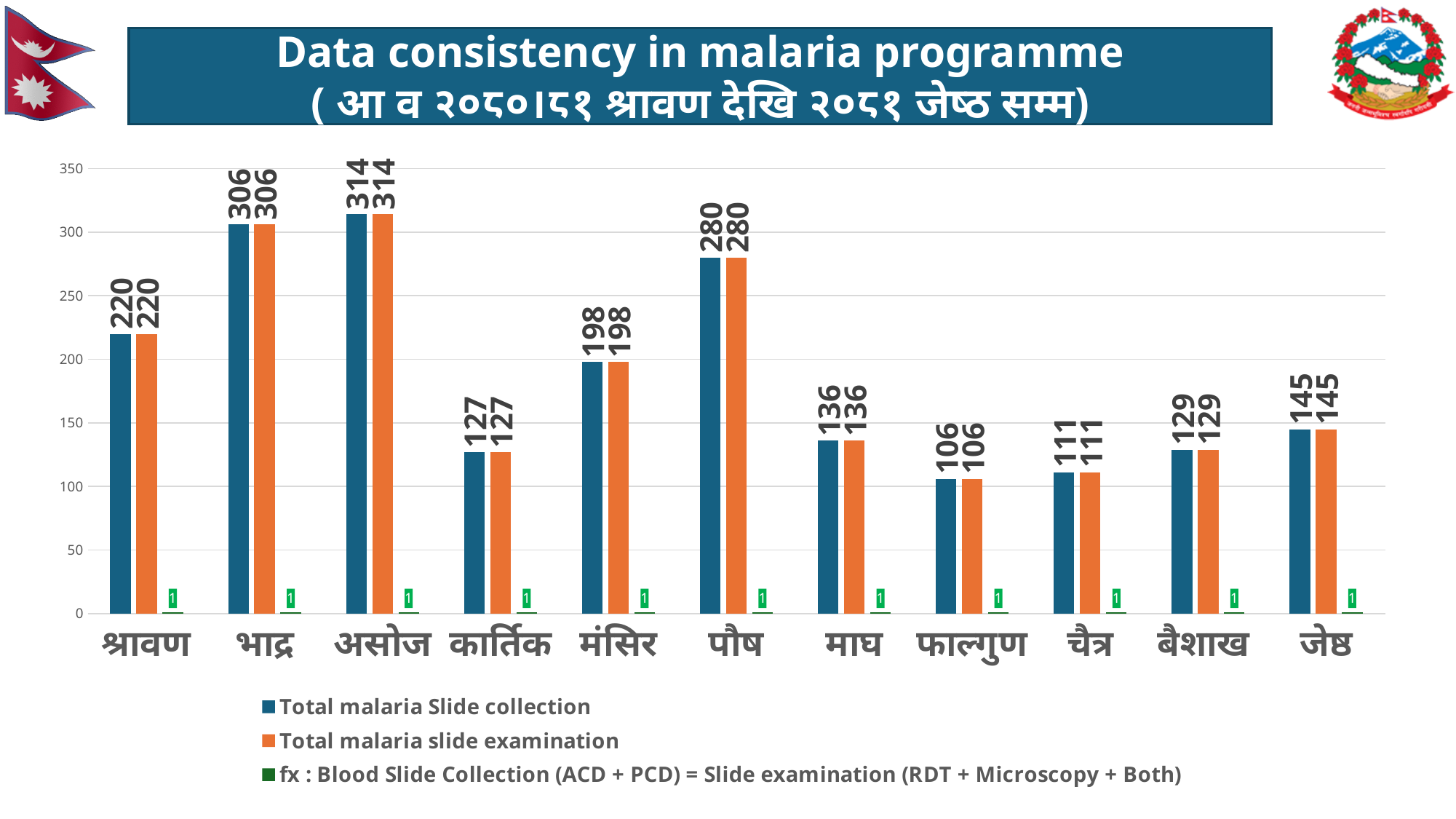
What is the difference between the Total malaria Slide collection for भाद्र and for श्रावण? 86 How many months are shown on the x axis? 11 What colour are the Total malaria slide examination bars? Orange What kind of chart is shown on the slide? Bar chart What is the Total malaria Slide collection value for असोज? 314 Which is larger, the Total malaria Slide collection for मंसिर or for जेष्ठ? मंसिर Which month has the lowest Total malaria slide examination? फाल्गुण What is the value of the fx series shown in green for each month? 1 Which month has the highest Total malaria Slide collection? असोज How many series does the legend list? 3 What is the Total malaria Slide collection value for फाल्गुण? 106 What is the Total malaria slide examination value for पौष? 280